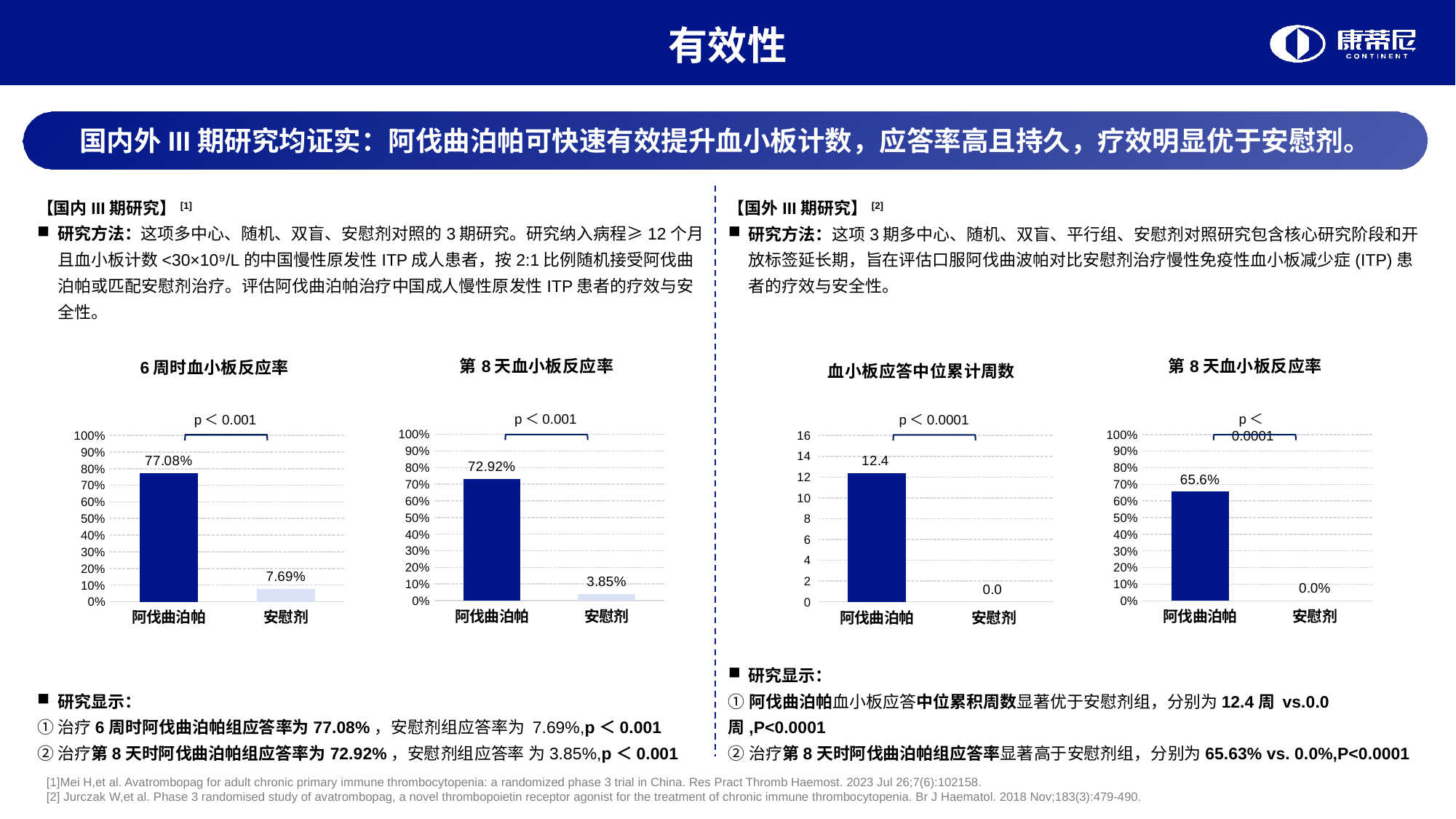
In the "第 8 天血小板反应率" chart on the right half of the slide (国外 III 期研究), what is the value for 阿伐曲泊帕? 65.6% In the chart titled "血小板应答中位累计周数", what is the value for 阿伐曲泊帕? 12.4 In the chart titled "6 周时血小板反应率", which category has the highest value? 阿伐曲泊帕 In the chart titled "6 周时血小板反应率", what is the value for 安慰剂? 7.69% In the "第 8 天血小板反应率" chart on the right half of the slide (国外 III 期研究), which category has the lowest value? 安慰剂 In the chart titled "血小板应答中位累计周数", what is the value for 安慰剂? 0.0 How many categories are shown on the x axis of the chart titled "6 周时血小板反应率"? 2 In the "第 8 天血小板反应率" chart on the left half of the slide (国内 III 期研究), what is the value for 安慰剂? 3.85% In the chart titled "6 周时血小板反应率", what is the value for 阿伐曲泊帕? 77.08% In the chart titled "6 周时血小板反应率", what is the difference between the 阿伐曲泊帕 and 安慰剂 values? 69.39% What kind of chart is the chart titled "血小板应答中位累计周数"? bar chart In the "第 8 天血小板反应率" chart on the left half of the slide (国内 III 期研究), what is the value for 阿伐曲泊帕? 72.92%